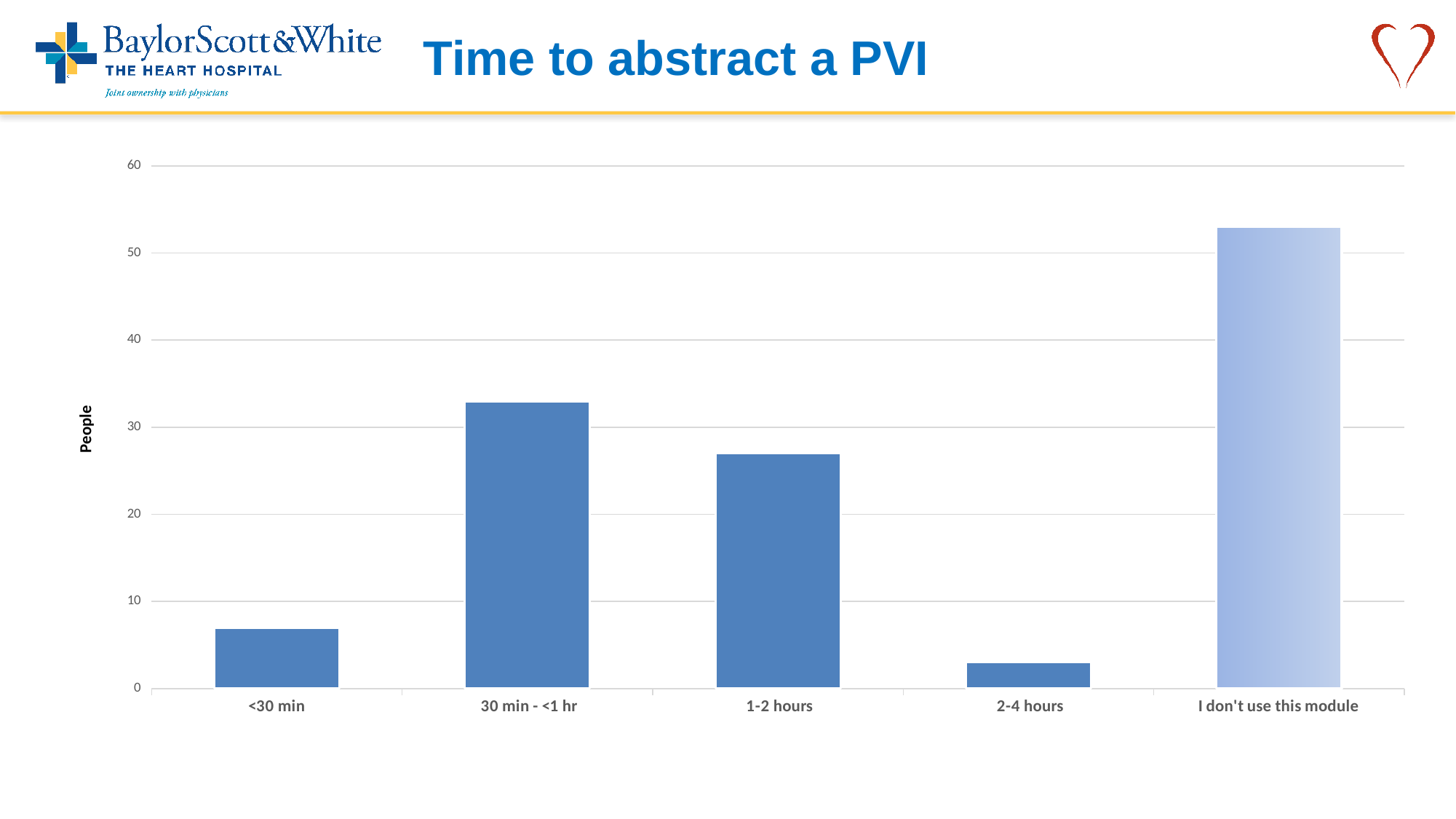
Which is larger, the value for "<30 min" or the value for "2-4 hours"? <30 min Is the value for "1-2 hours" greater or less than 30? less Which category has the lowest bar? 2-4 hours Which is larger, the value for "30 min - <1 hr" or the value for "1-2 hours"? 30 min - <1 hr What is the label on the vertical axis of the chart? People What kind of chart is shown on the slide? bar chart Is the value for "<30 min" greater or less than 10? less Is the value for "30 min - <1 hr" greater or less than 30? greater Which category has the highest bar? I don't use this module How many categories are shown on the x axis of the chart? 5